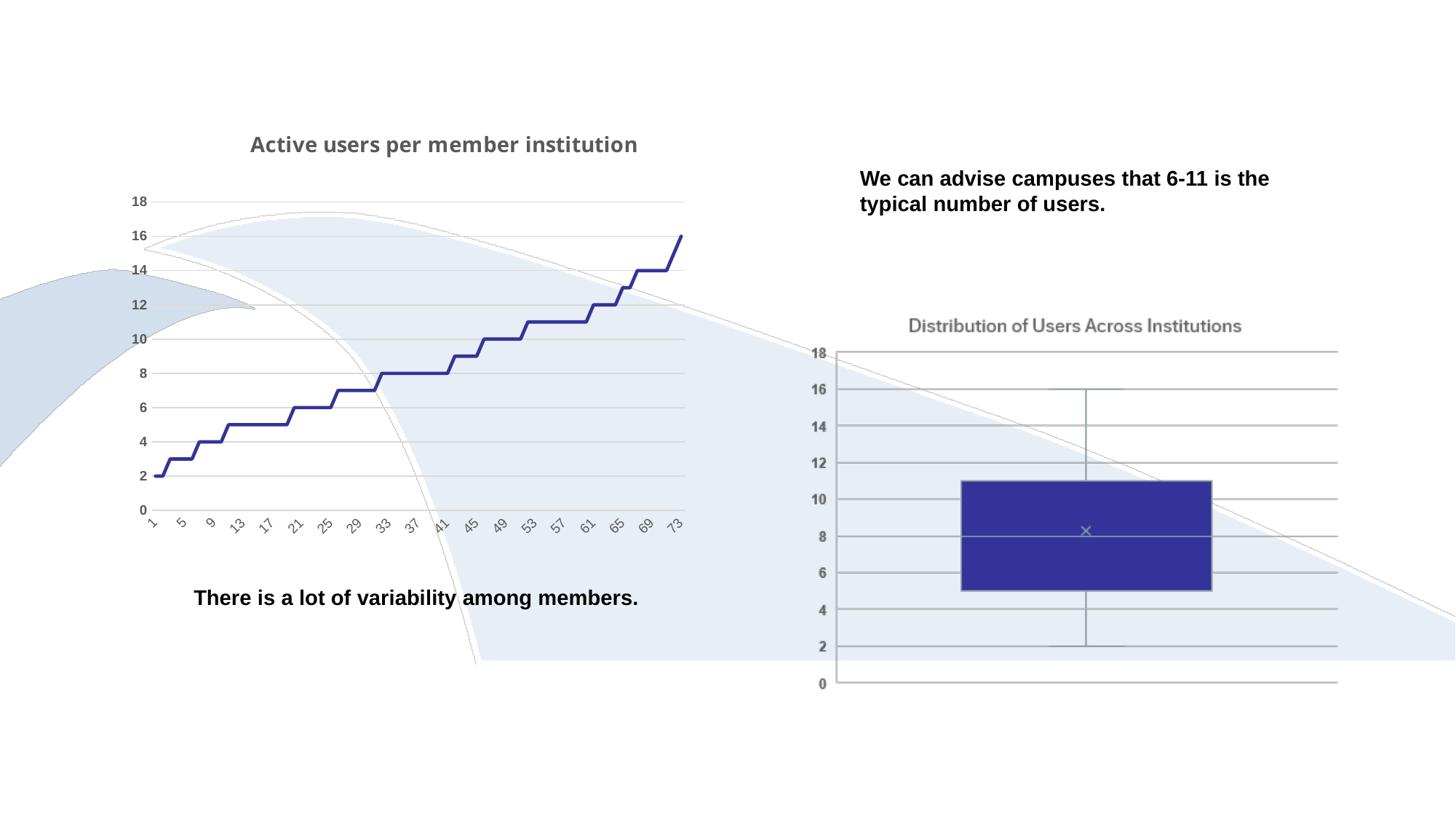
In the 'Distribution of Users Across Institutions' chart, is the top of the upper whisker greater or less than 14? greater In the 'Active users per member institution' chart, at which x value is the line highest? 73 In the 'Active users per member institution' chart, do the values rise or fall along the x axis? rise What is the title of the chart on the left of the slide? Active users per member institution In the 'Active users per member institution' chart, what is the value at x = 1? 2 What kind of chart is the 'Active users per member institution' chart? line chart In the 'Active users per member institution' chart, is the value at x = 41 greater or less than 10? less In the 'Distribution of Users Across Institutions' chart, is the bottom of the box greater or less than 4? greater In the 'Active users per member institution' chart, which is larger, the value at x = 1 or the value at x = 73? x = 73 In the 'Active users per member institution' chart, what is the value at x = 73? 16 What kind of chart is the 'Distribution of Users Across Institutions' chart? box plot